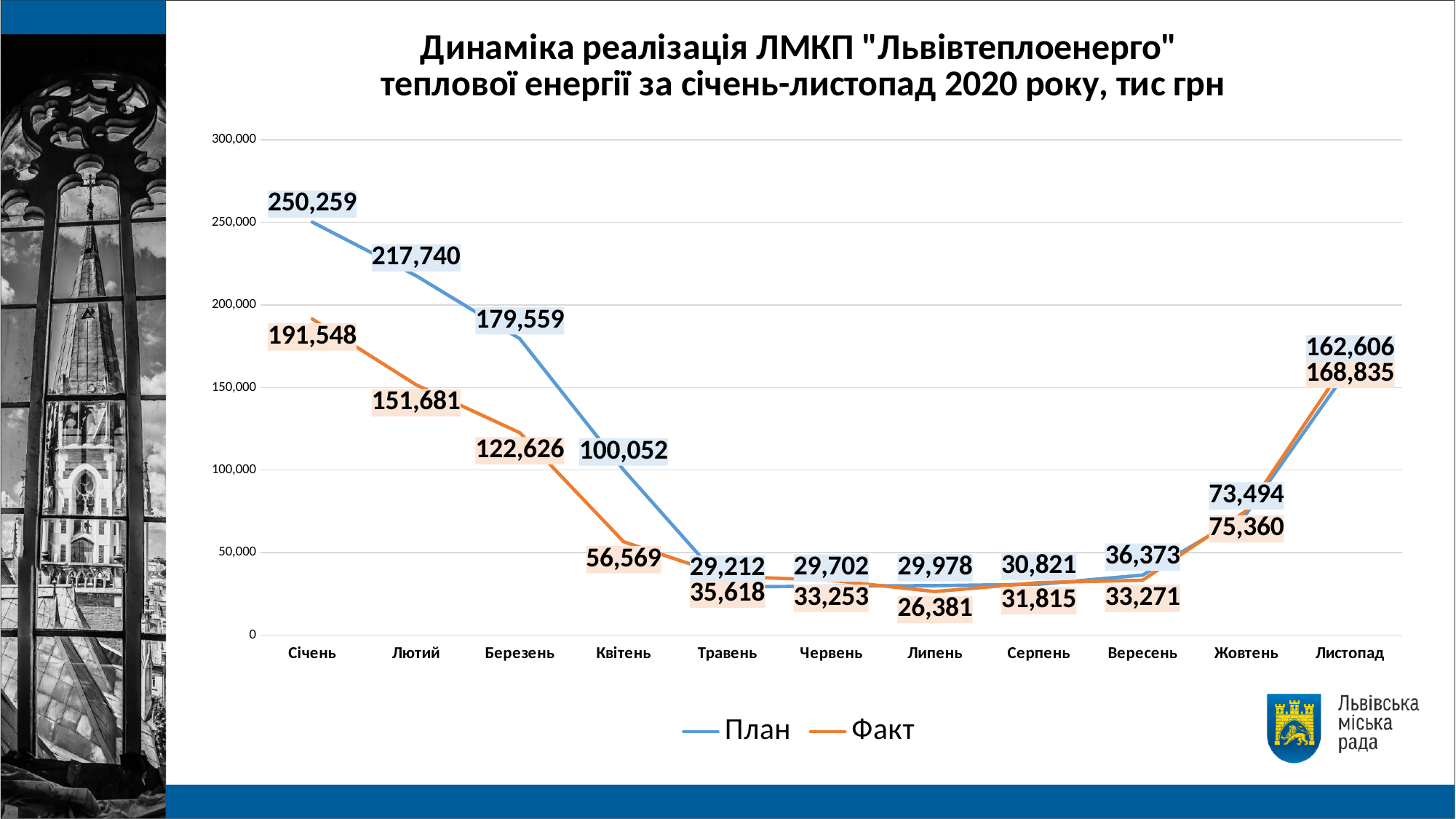
In which month is the Факт value lowest? Липень How many months are shown on the x axis? 11 What is the Факт value for Квітень? 56,569 How many series does the legend list? 2 What kind of chart is shown on the slide? Line chart What is the difference between the План and Факт values for Січень? 58,711 What is the План value for Січень? 250,259 Does the План value rise or fall from Січень to Травень? Fall What is the Факт value for Листопад? 168,835 What is the План value for Жовтень? 73,494 In which month is the План value highest? Січень Which is larger for Березень, the План value or the Факт value? План